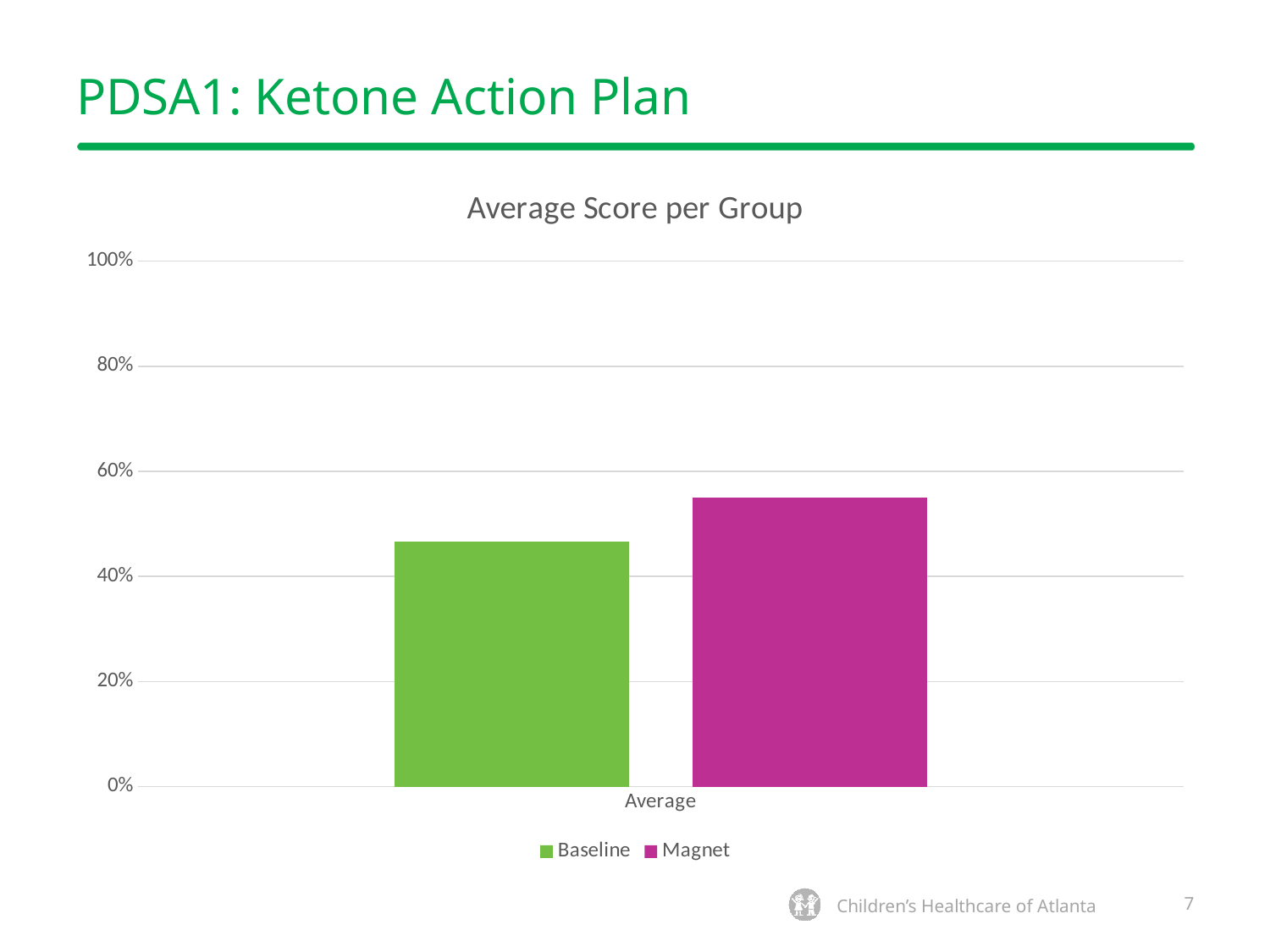
What colour is the Magnet bar? magenta Is the value for Baseline greater or less than 40%? greater Which series has the higher value for Average, Baseline or Magnet? Magnet Is the value for Magnet greater or less than 40%? greater What kind of chart is shown on the slide? bar chart How many series does the legend list? 2 What is the title of the chart? Average Score per Group Which series has the lowest value in the chart? Baseline Is the value for Baseline greater or less than 60%? less How many categories are shown on the x axis? 1 Which series has the highest value in the chart? Magnet